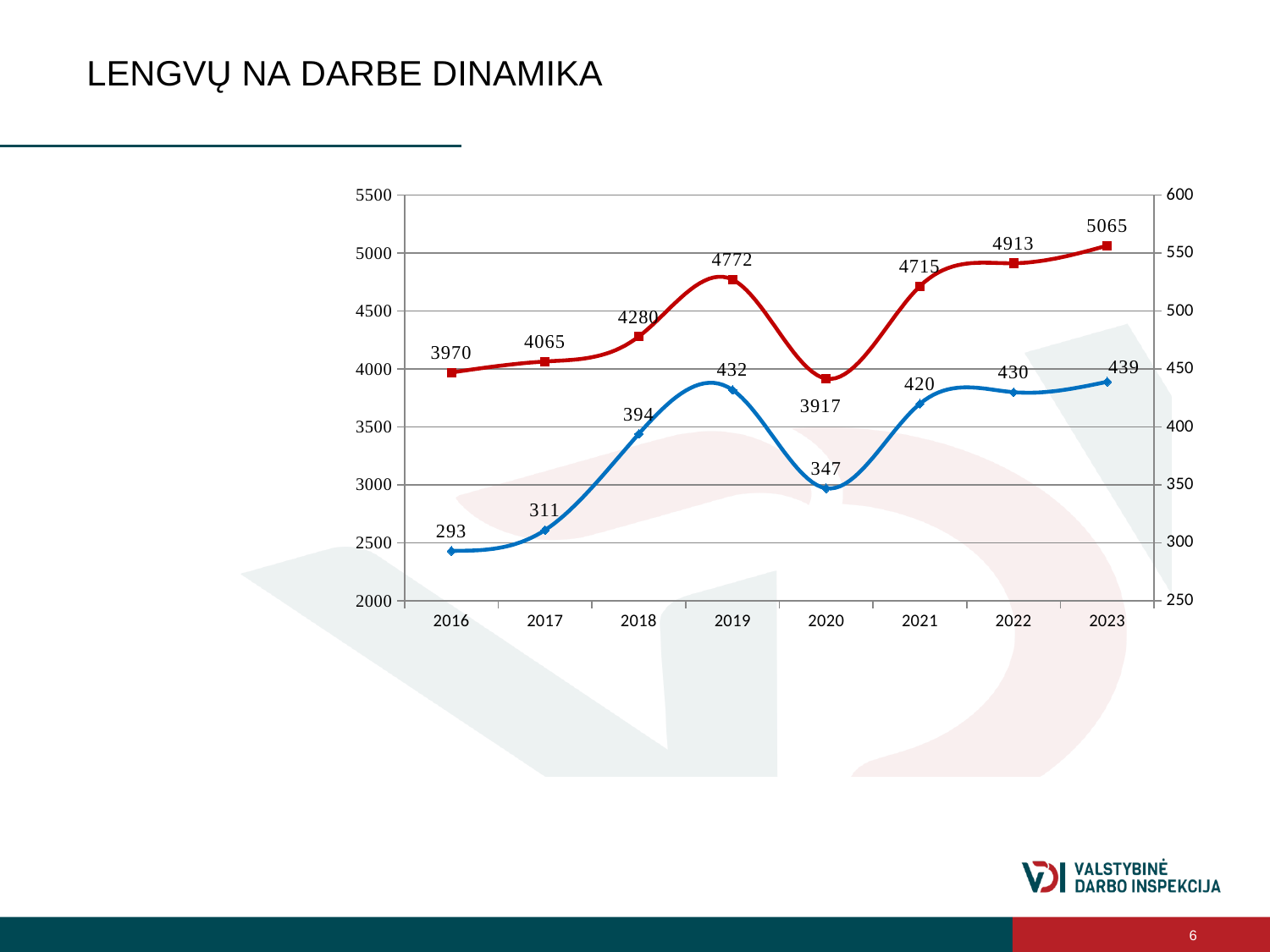
In which year does the blue line have its lowest value? 2016 What is the value of the red line in 2023? 5065 In which year does the red line reach its highest value? 2023 Which year has the larger value on the red line, 2018 or 2021? 2021 What is the title of the slide containing the chart? LENGVŲ NA DARBE DINAMIKA What type of chart is shown on the slide? line chart How many years are shown on the x axis? 8 What is the difference between the red line's values in 2019 and 2020? 855 Does the red line rise or fall from 2020 to 2023? rise What is the value of the blue line in 2020? 347 What is the value of the red line in 2019? 4772 What is the difference between the blue line's values in 2023 and 2016? 146